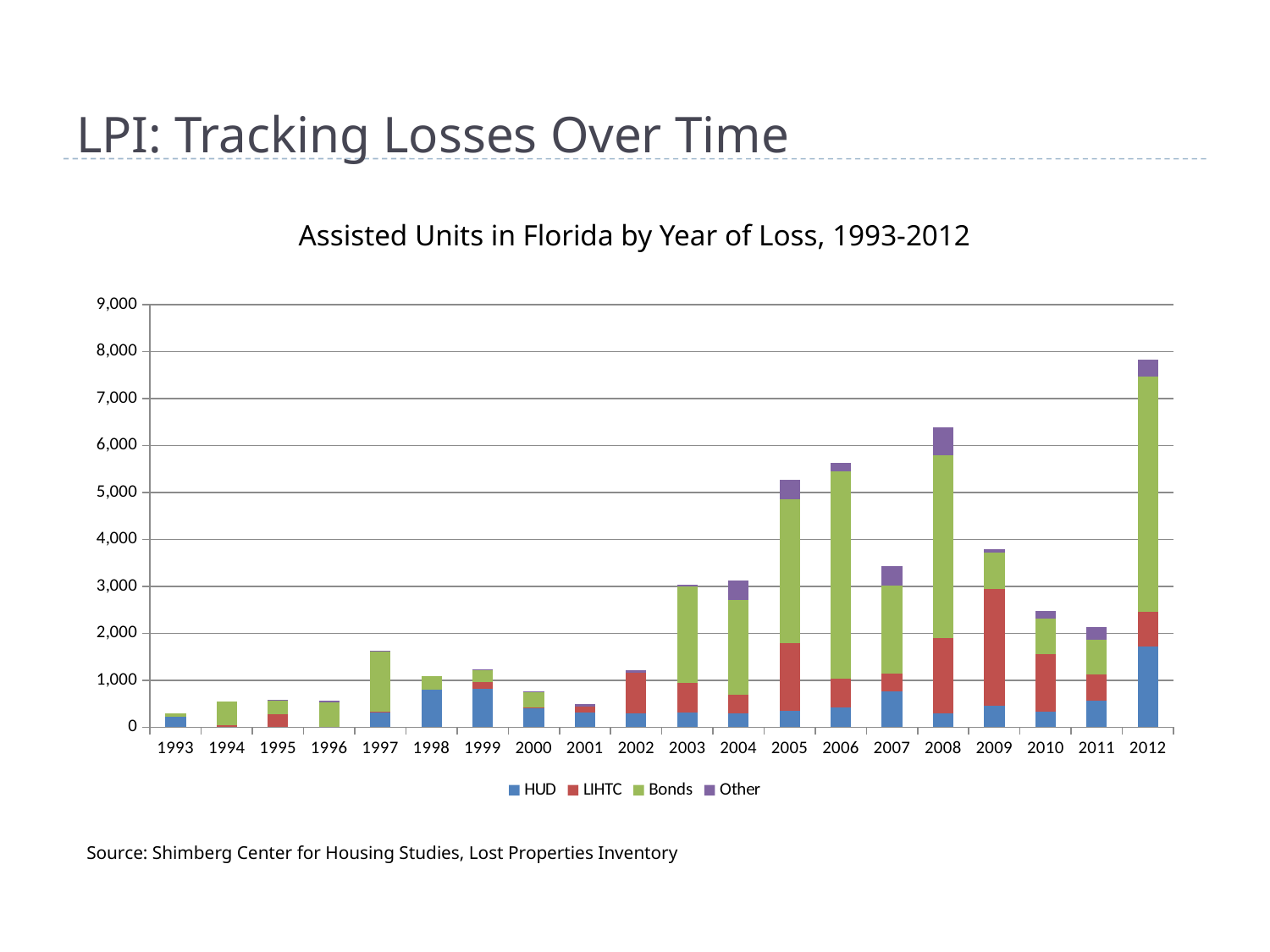
Is the total for 2008 greater or less than 6,000? greater What kind of chart is shown on the slide? Stacked bar chart Which year has the lowest total of assisted units lost? 1993 What is the title of the chart? Assisted Units in Florida by Year of Loss, 1993-2012 Which year has a larger total, 2008 or 2006? 2008 Is the total for 2012 greater or less than 7,000? greater Which year has the highest total of assisted units lost? 2012 Is the total for 1997 greater or less than 1,000? greater Which year has a larger total, 2012 or 2005? 2012 How many series does the legend list? 4 How many years are shown on the x axis? 20